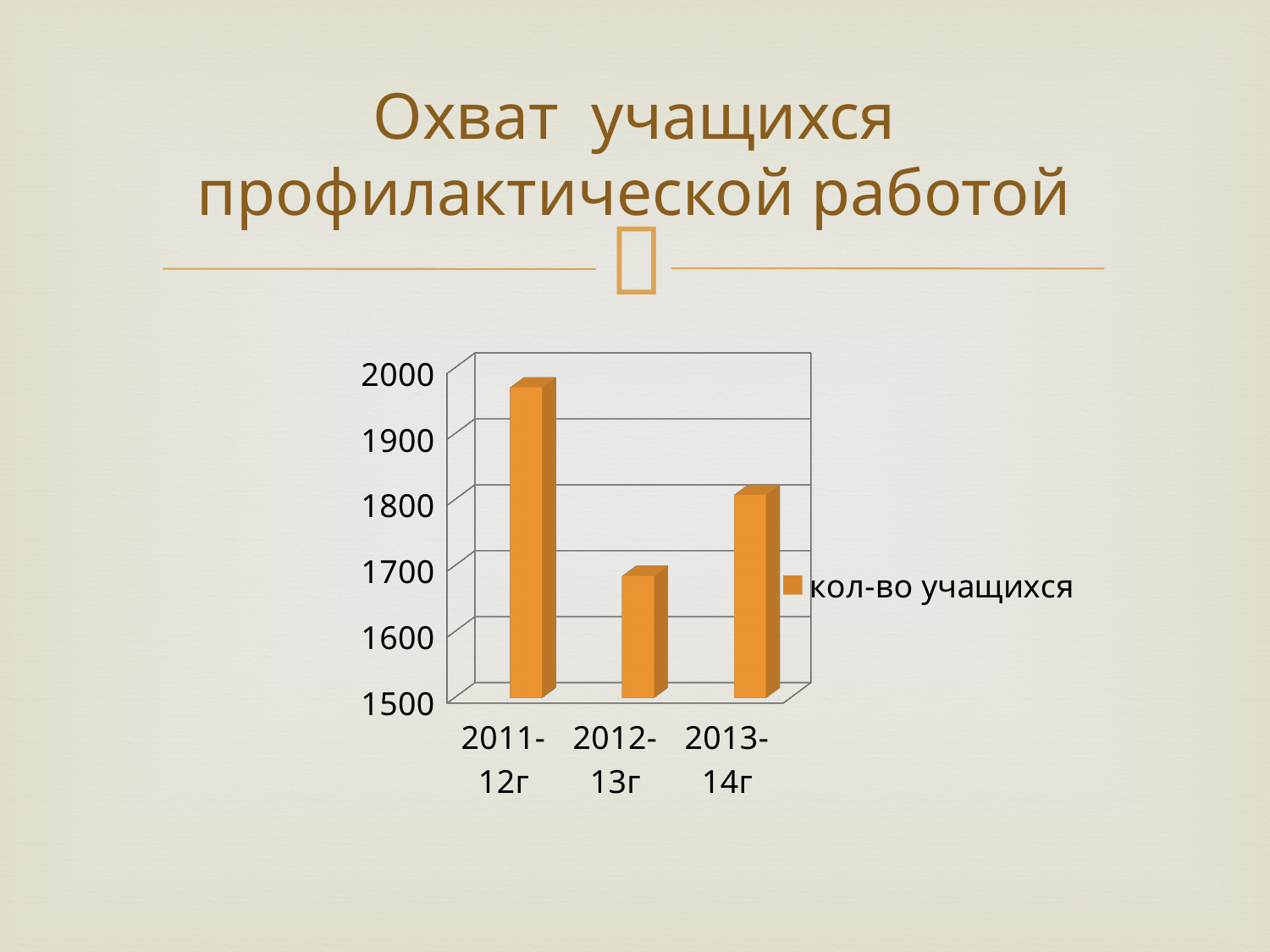
Is the value for 2012-13г greater or less than 1600? greater How many series does the chart's legend list? 1 Is the value for 2011-12г greater or less than 1900? greater Which category has the lowest value in the chart? 2012-13г What is the series name shown in the chart's legend? кол-во учащихся What is the title of the slide containing the chart? Охват учащихся профилактической работой Which category has the highest value in the chart? 2011-12г How many categories are shown on the x axis of the chart? 3 Is the value for 2013-14г greater or less than 1900? less Does the value rise or fall from 2011-12г to 2012-13г? fall Which is larger, the value for 2013-14г or the value for 2012-13г? 2013-14г What kind of chart is shown on the slide? bar chart